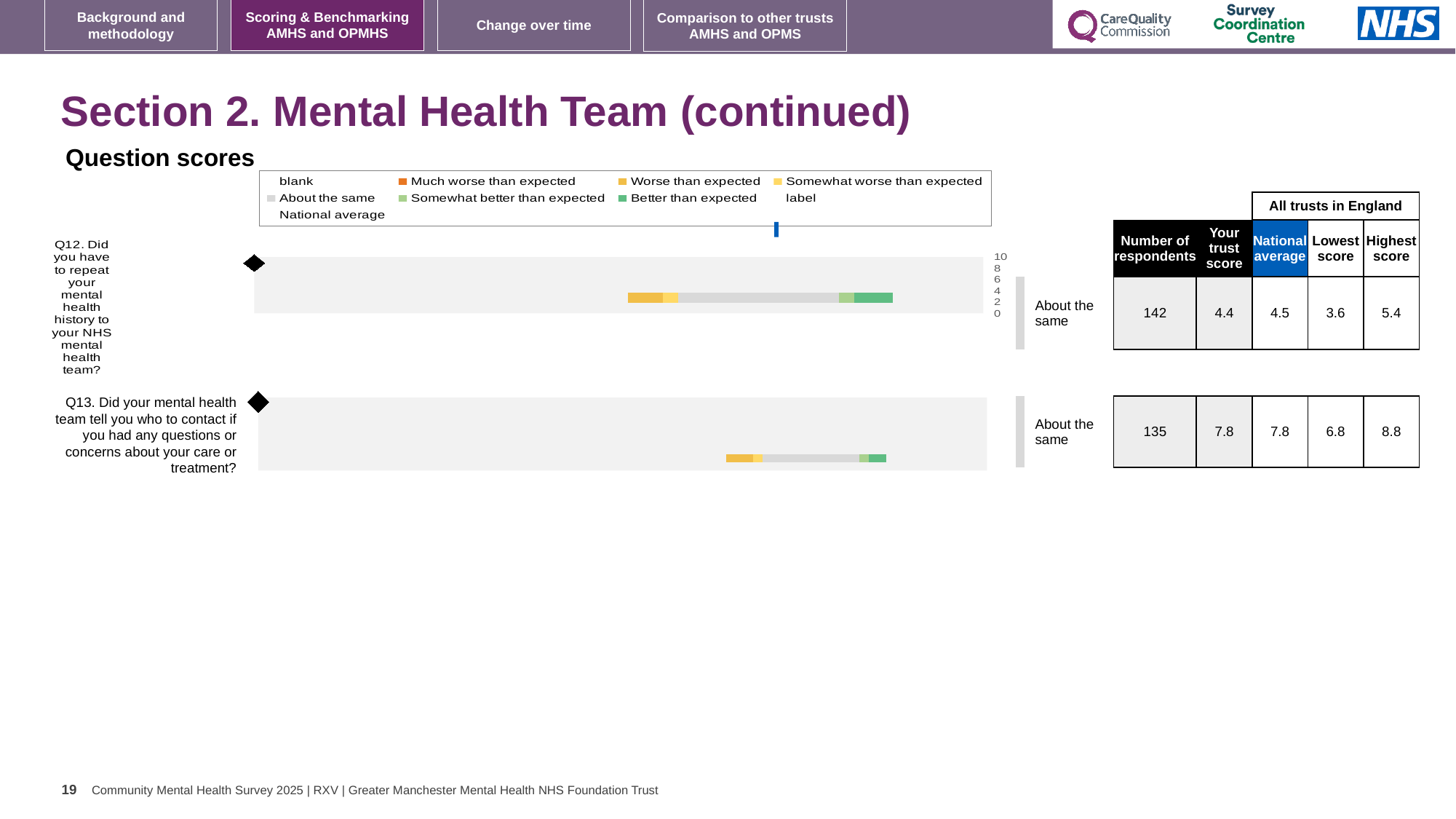
What is the trust score for Q12 (Did you have to repeat your mental health history to your NHS mental health team?)? 4.4 What is the lowest score among all trusts in England for Q12? 3.6 What is the benchmark category shown for Q13? About the same What is the national average score for Q13 (Did your mental health team tell you who to contact if you had any questions or concerns about your care or treatment?)? 7.8 Which question has the higher trust score, Q12 or Q13? Q13 What is the difference between the national average and the trust score for Q12? 0.1 What colour does the legend use for 'Better than expected'? Green What is the highest score among all trusts in England for Q13? 8.8 How many questions are plotted on this slide? 2 What is the difference between the highest and lowest scores for Q12? 1.8 What kind of chart is used to show the question scores? Bar chart How many respondents answered Q12? 142